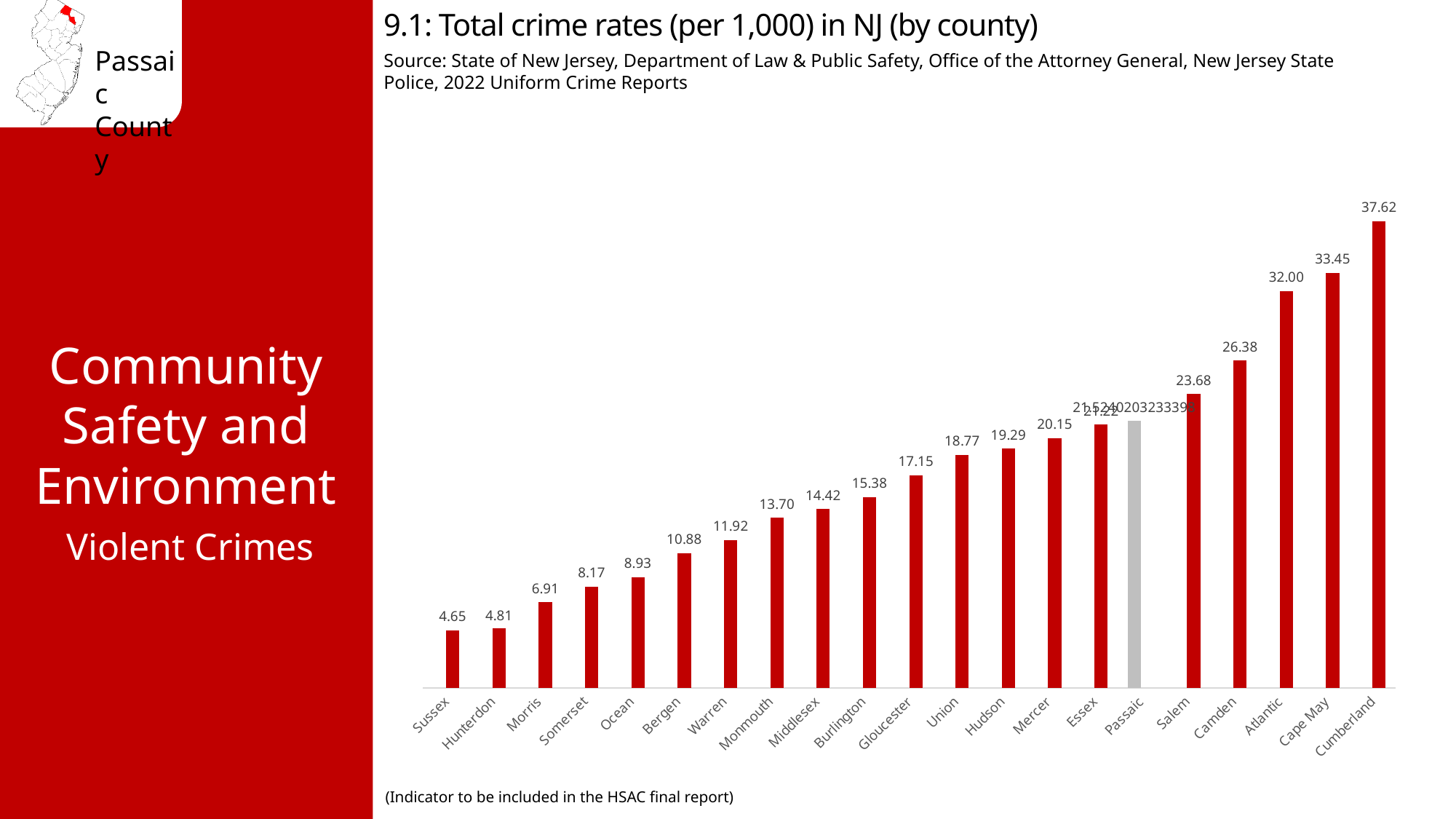
What is the difference between the total crime rates of Union and Gloucester? 1.62 What is the difference between the total crime rates of Cape May and Atlantic? 1.45 How many counties are shown in the chart? 21 What is the total crime rate (per 1,000) for Camden? 26.38 Which county has the highest total crime rate? Cumberland Which county has the lowest total crime rate? Sussex Do the values rise or fall moving from left to right along the x axis? rise Which county has a higher total crime rate, Hudson or Mercer? Mercer What is the total crime rate (per 1,000) for Cumberland? 37.62 What type of chart is shown on the slide? bar chart What is the total crime rate (per 1,000) for Bergen? 10.88 What is the total crime rate (per 1,000) for Sussex? 4.65